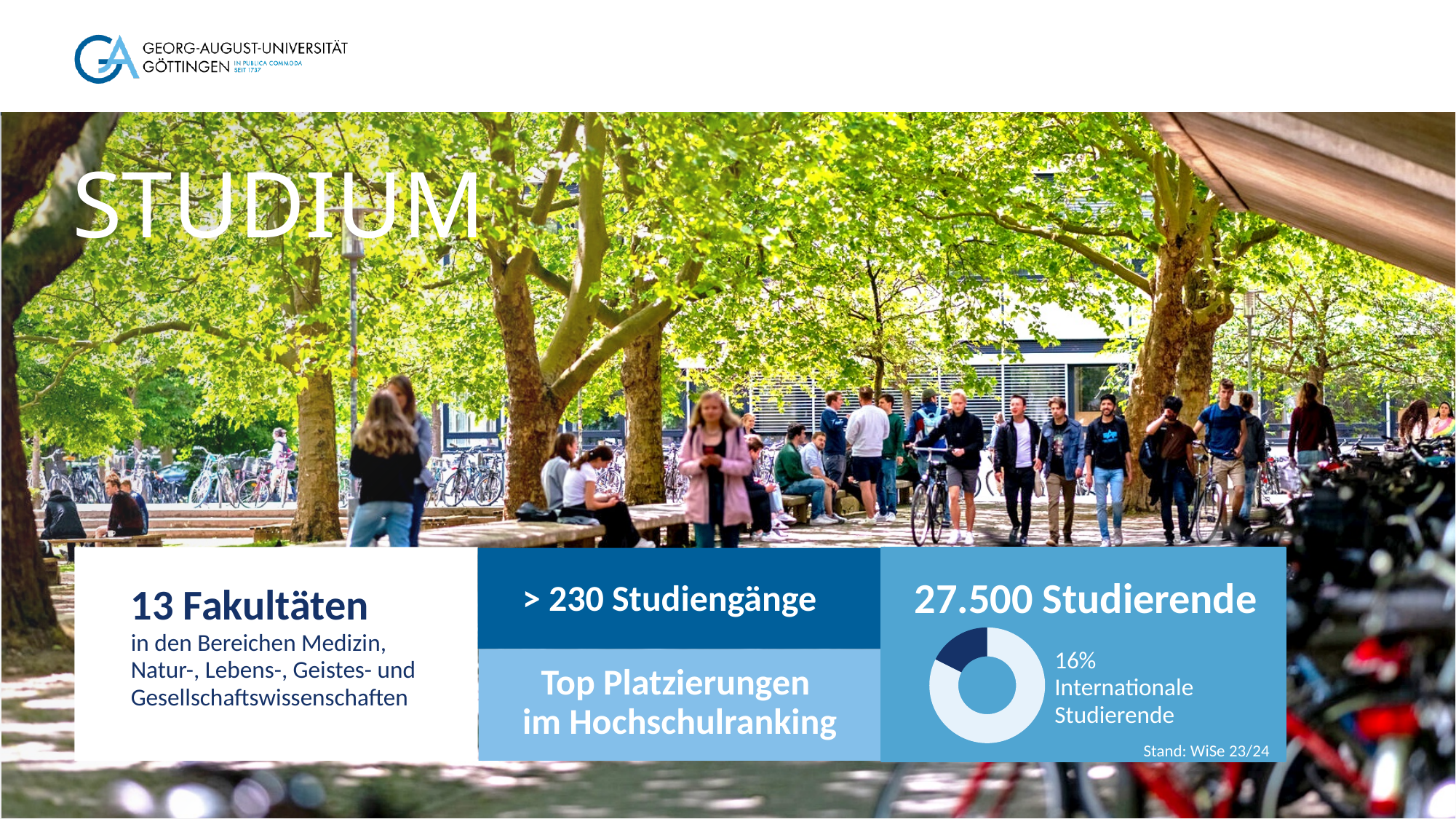
What kind of chart is shown in the '27.500 Studierende' box? pie chart (donut) What label is printed next to the donut chart? 16% Internationale Studierende Is the share of international students shown in the donut chart greater or less than 50%? less How many slices does the donut chart have? 2 Which slice of the donut chart is larger: the international students slice or the remaining students slice? the remaining students slice According to the donut chart, what share of students are international students? 16% What date reference is given below the donut chart? Stand: WiSe 23/24